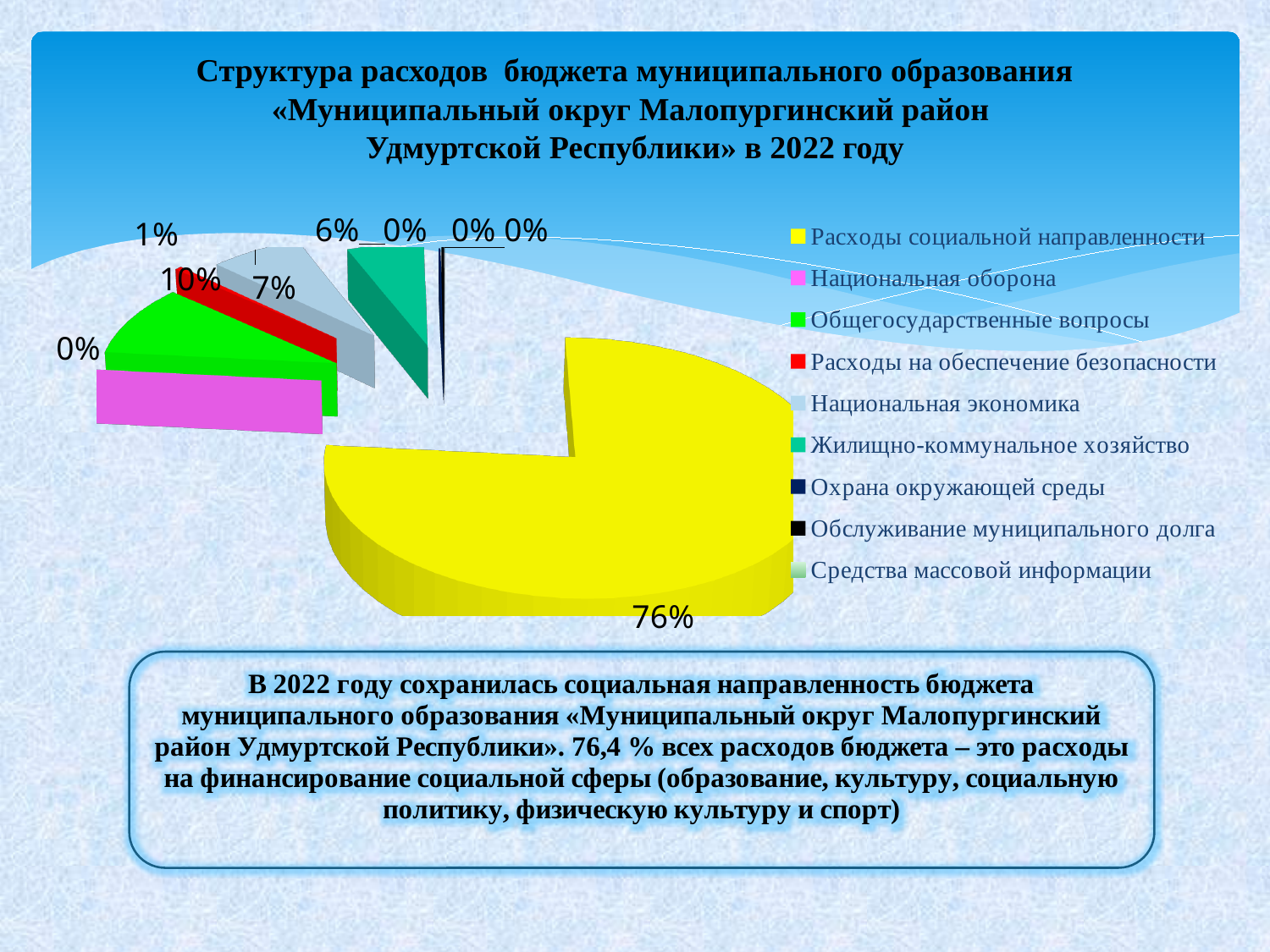
What share of the pie is labelled for «Национальная экономика»? 7% What kind of chart is shown on the slide? pie chart Which year does the chart title say the budget expenditure structure refers to? 2022 What share of the pie is labelled for «Жилищно-коммунальное хозяйство»? 6% Which is larger: the slice for «Расходы социальной направленности» or the slice for «Национальная экономика»? Расходы социальной направленности What is the difference between the shares of «Национальная экономика» and «Жилищно-коммунальное хозяйство»? 1% How many categories does the legend of the pie chart list? 9 What colour is the slice for «Расходы социальной направленности»? yellow What share of the pie does «Расходы социальной направленности» take? 76% Which category has the largest slice of the pie? Расходы социальной направленности